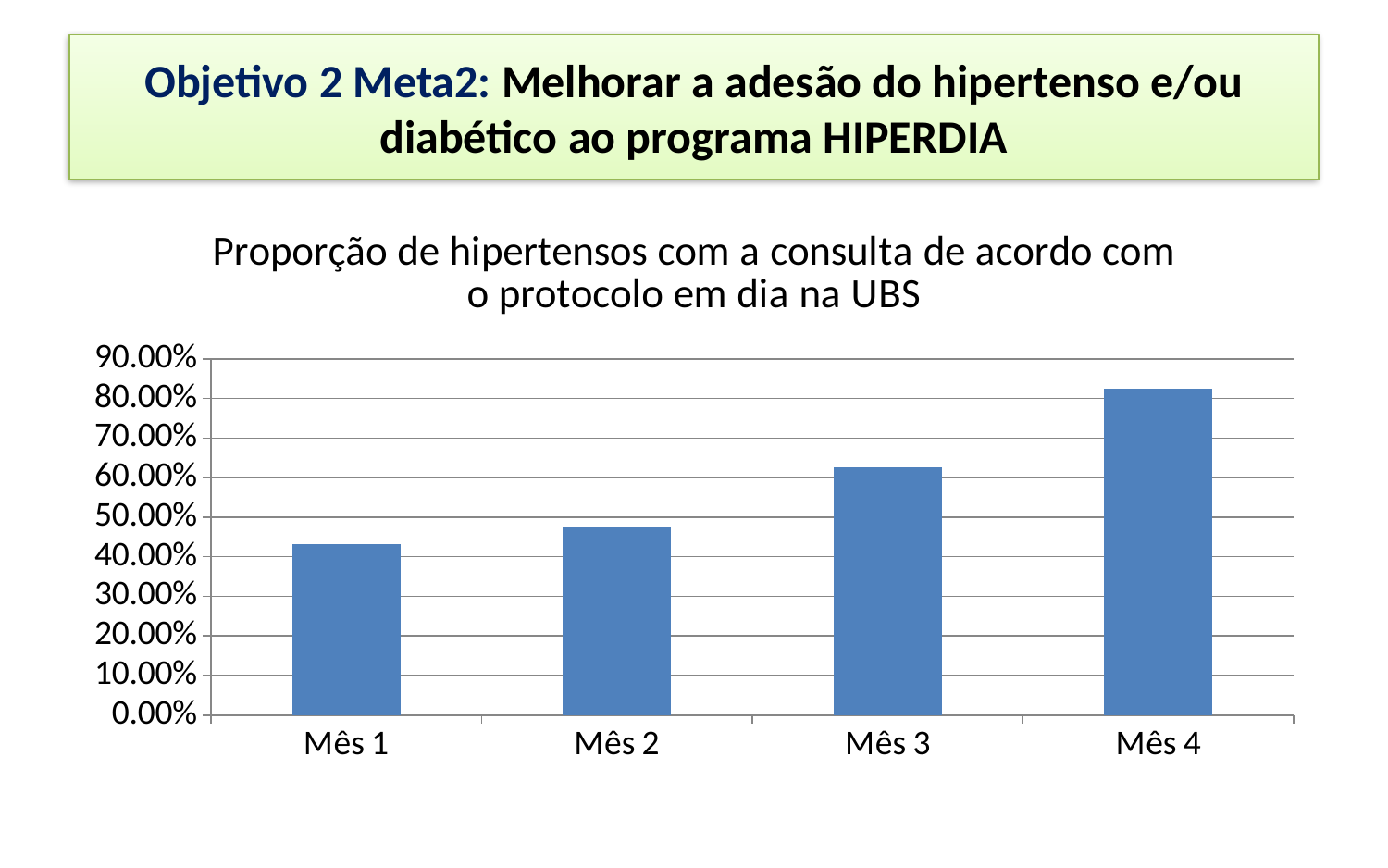
Which month has the highest proportion of hypertensive patients with consultations up to date? Mês 4 Is the value for Mês 4 greater or less than 80.00%? greater Is the value for Mês 1 greater or less than 50.00%? less Which month has the lowest proportion of hypertensive patients with consultations up to date? Mês 1 Do the values rise or fall from Mês 1 to Mês 4? rise Which is larger, the value for Mês 3 or the value for Mês 2? Mês 3 How many months (categories) are plotted on the chart? 4 What kind of chart is shown on the slide? bar chart What is the title of the chart? Proporção de hipertensos com a consulta de acordo com o protocolo em dia na UBS Is the value for Mês 2 greater or less than 50.00%? less What is the highest value shown on the vertical axis? 90.00%